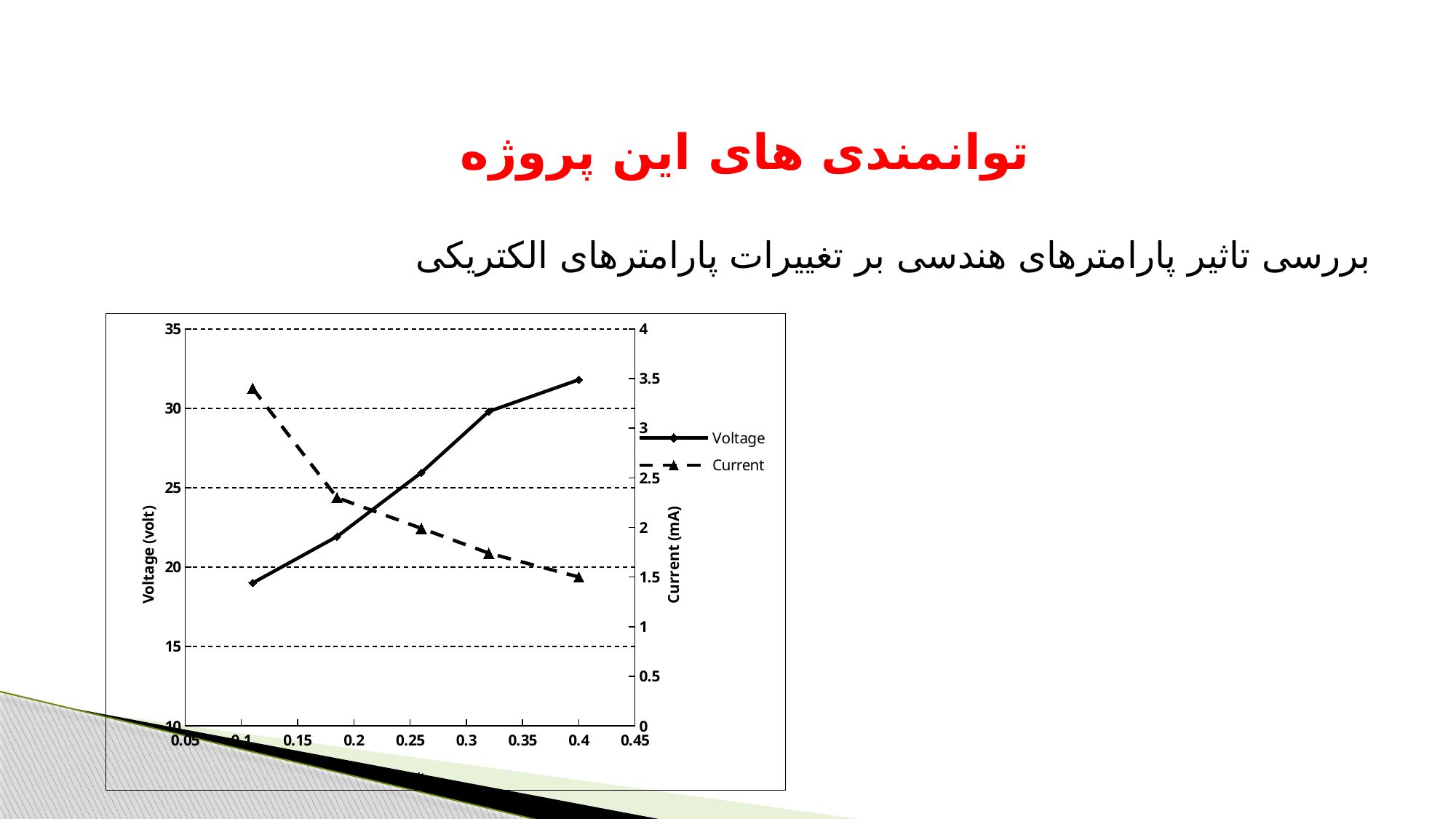
Does the Current series rise or fall as the x-axis value increases? fall Is the Voltage value at the rightmost data point greater or less than 30? greater How many data points are plotted for the Voltage series? 5 Is the Voltage value at the leftmost data point greater or less than 20? less What is the label of the right-hand vertical axis? Current (mA) What are the two series named in the legend? Voltage and Current What kind of chart is shown on the slide? line chart How many series does the legend list? 2 Does the Voltage series rise or fall as the x-axis value increases? rise Is the Voltage series highest at its leftmost or its rightmost data point? rightmost Is the Current value at the leftmost data point greater or less than 3? greater